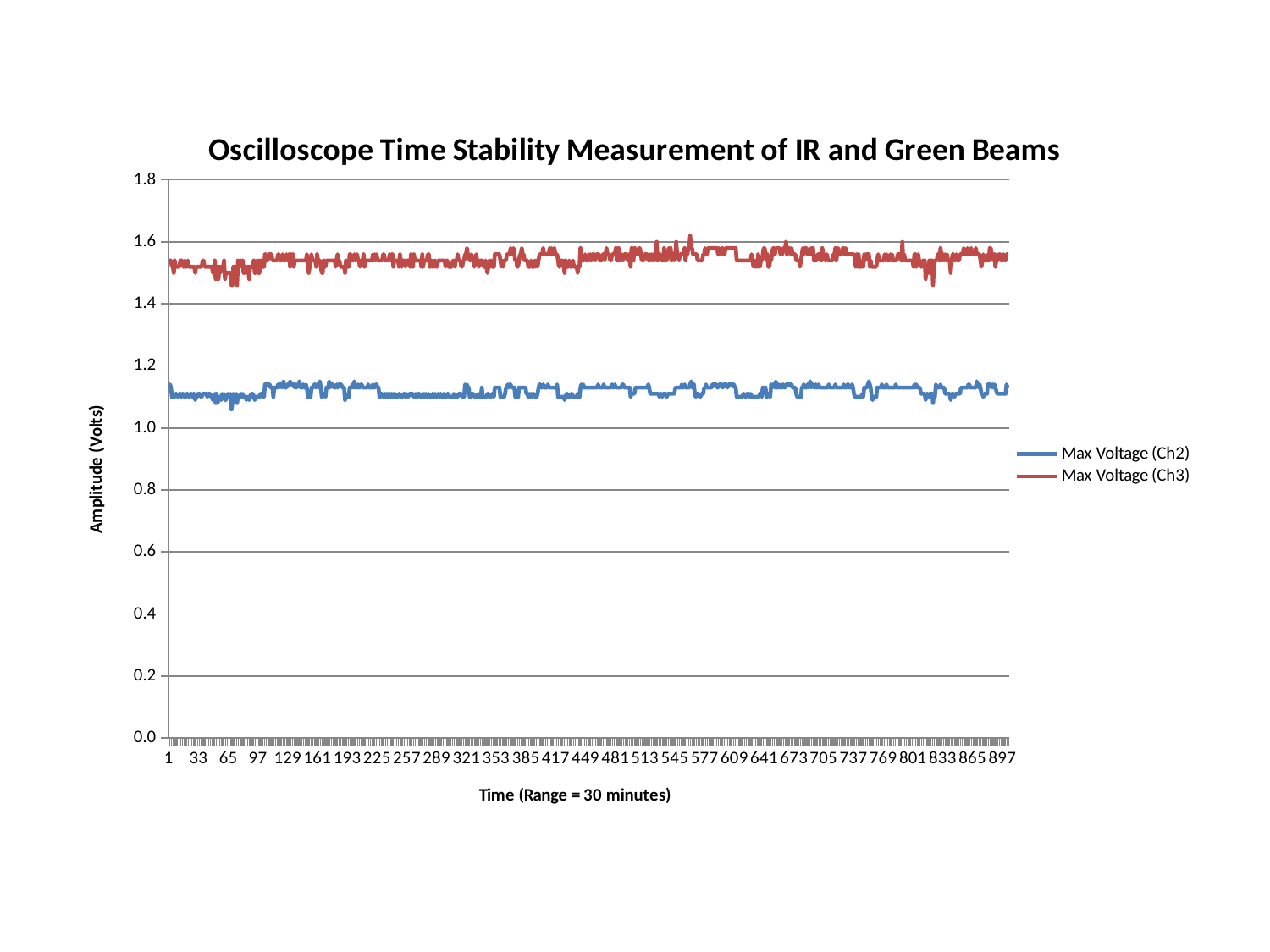
Do the values for Max Voltage (Ch3) rise, fall, or stay roughly flat along the x axis? stay roughly flat What is the title of the chart? Oscilloscope Time Stability Measurement of IR and Green Beams What is the highest value shown on the vertical axis? 1.8 What kind of chart is shown on the slide? line chart What is the label of the vertical axis? Amplitude (Volts) Which series has the lower values, Max Voltage (Ch2) or Max Voltage (Ch3)? Max Voltage (Ch2) How many series does the legend list? 2 Are the values for Max Voltage (Ch3) greater or less than 1.4? greater Are the values for Max Voltage (Ch2) greater or less than 1.0? greater Are the values for Max Voltage (Ch3) greater or less than 1.8? less Which series has higher values throughout, Max Voltage (Ch2) or Max Voltage (Ch3)? Max Voltage (Ch3)